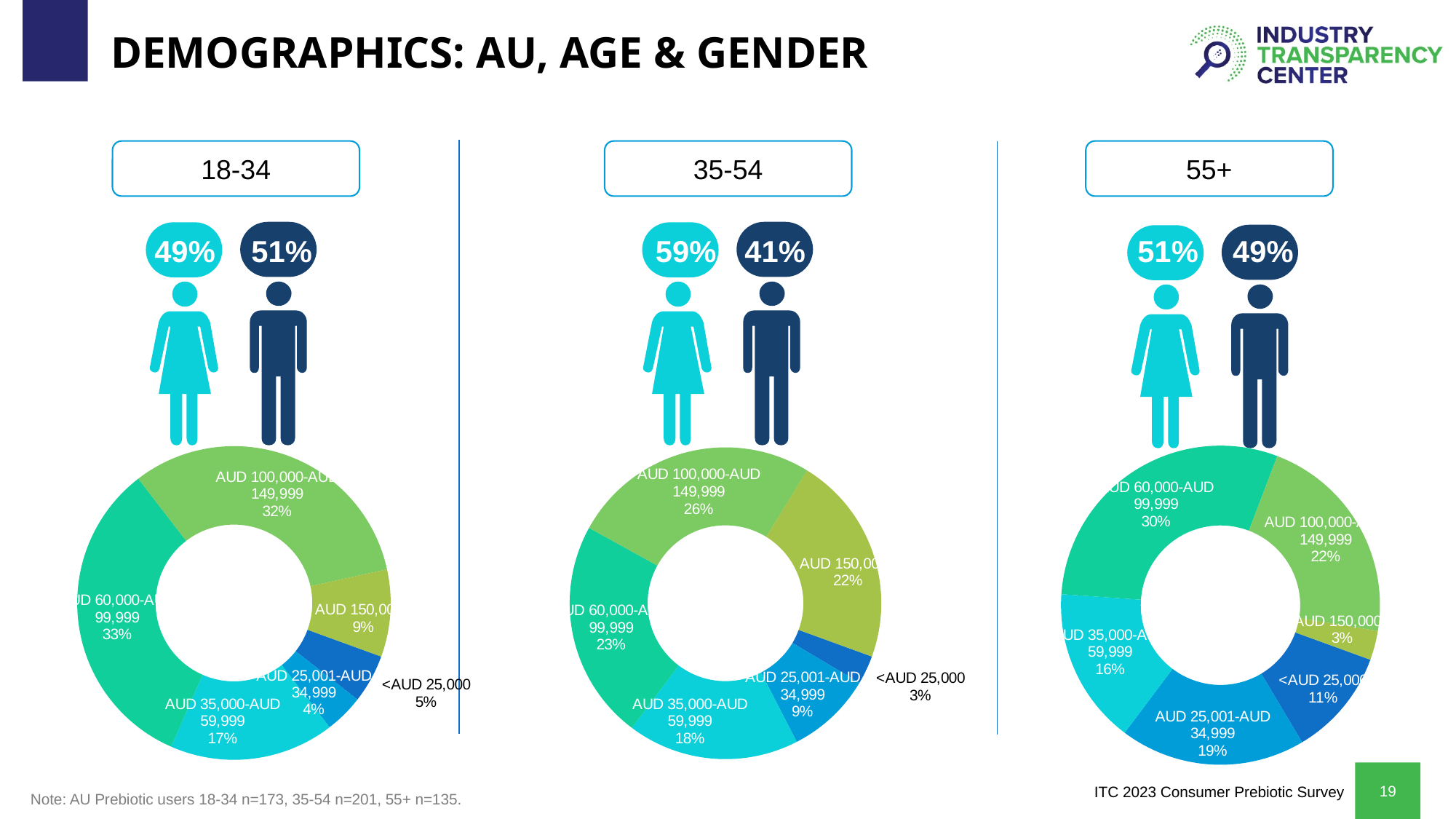
In the 35-54 donut chart, which income bracket has the largest share? AUD 100,000-AUD 149,999 In the 35-54 donut chart, which is larger: the share for AUD 35,000-AUD 59,999 or the share for AUD 25,001-AUD 34,999? AUD 35,000-AUD 59,999 In the 18-34 donut chart, which income bracket has the smallest share? AUD 25,001-AUD 34,999 In the 55+ donut chart, which income bracket has the smallest share? AUD 150,000+ What type of chart is used to show the income breakdown for each age group? Donut chart In the 18-34 donut chart, what is the difference between the shares for AUD 100,000-AUD 149,999 and AUD 150,000+? 23% How many income brackets are shown in the 55+ donut chart? 6 What percentage of the 35-54 group is female according to the slide? 59% In the 55+ donut chart, what share is shown for AUD 25,001-AUD 34,999? 19% In the 18-34 donut chart, what share is shown for AUD 60,000-AUD 99,999? 33% In the 35-54 donut chart, what share is shown for AUD 150,000+? 22% In the 55+ donut chart, what is the difference between the shares for AUD 60,000-AUD 99,999 and <AUD 25,000? 19%